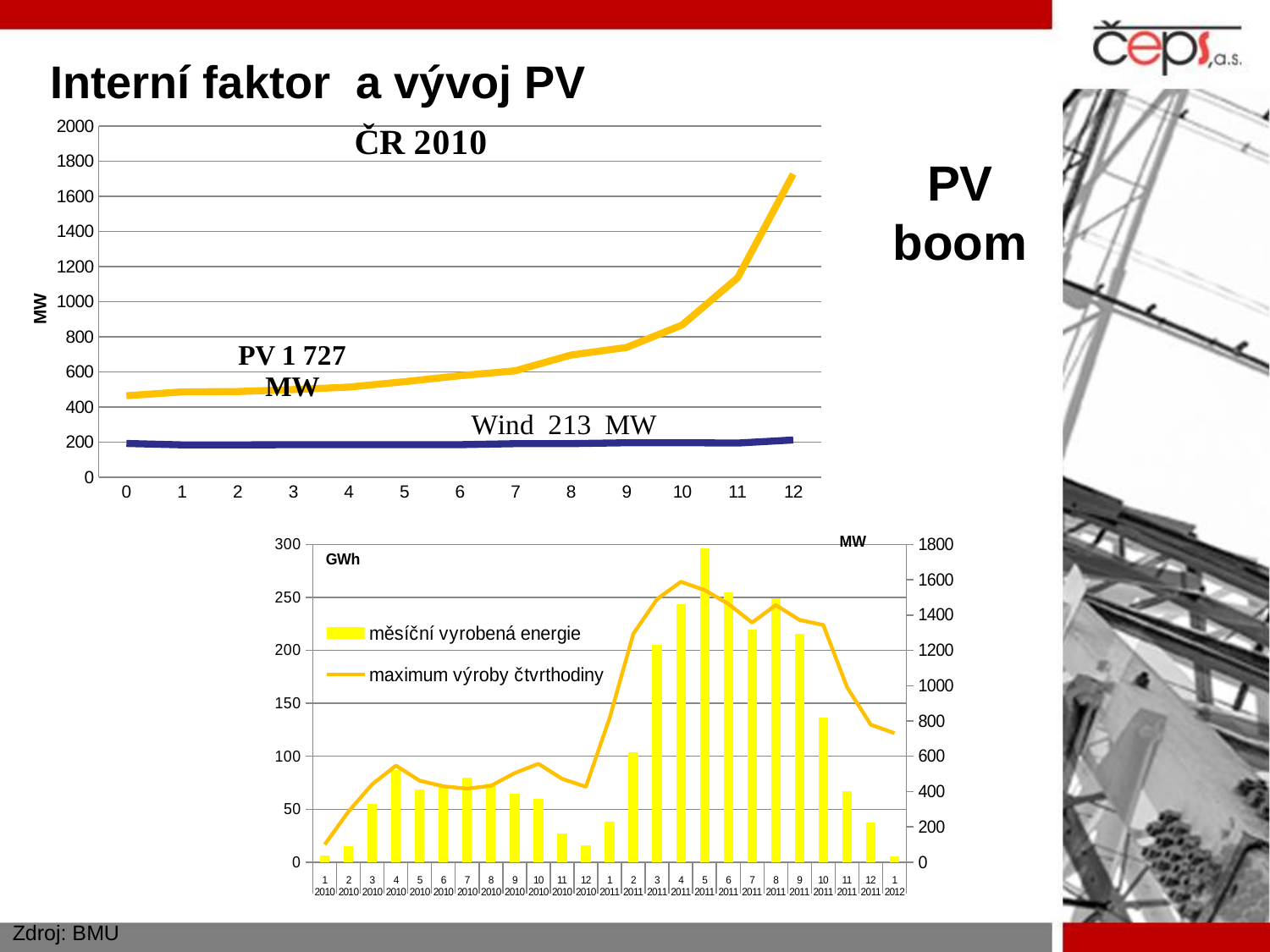
In the top chart titled ČR 2010, what value is annotated for PV? 1 727 MW What kind of chart is the top chart titled ČR 2010? line chart In the bottom chart, what is the unit label shown on the left axis? GWh In the top chart titled ČR 2010, which series is larger at x = 12, PV or Wind? PV In the bottom chart, is the bar for měsíční vyrobená energie in 12 2010 greater or less than 50 GWh? less In the top chart titled ČR 2010, does the PV line rise or fall along the x axis? rise In the top chart titled ČR 2010, what value is annotated for Wind? 213 MW In the bottom chart, how many series does the legend list? 2 In the top chart titled ČR 2010, is the Wind value at x = 12 greater or less than 400? less In the bottom chart, which month has the highest bar for měsíční vyrobená energie? 5 2011 In the bottom chart, is the bar for měsíční vyrobená energie in 5 2011 greater or less than 250 GWh? greater